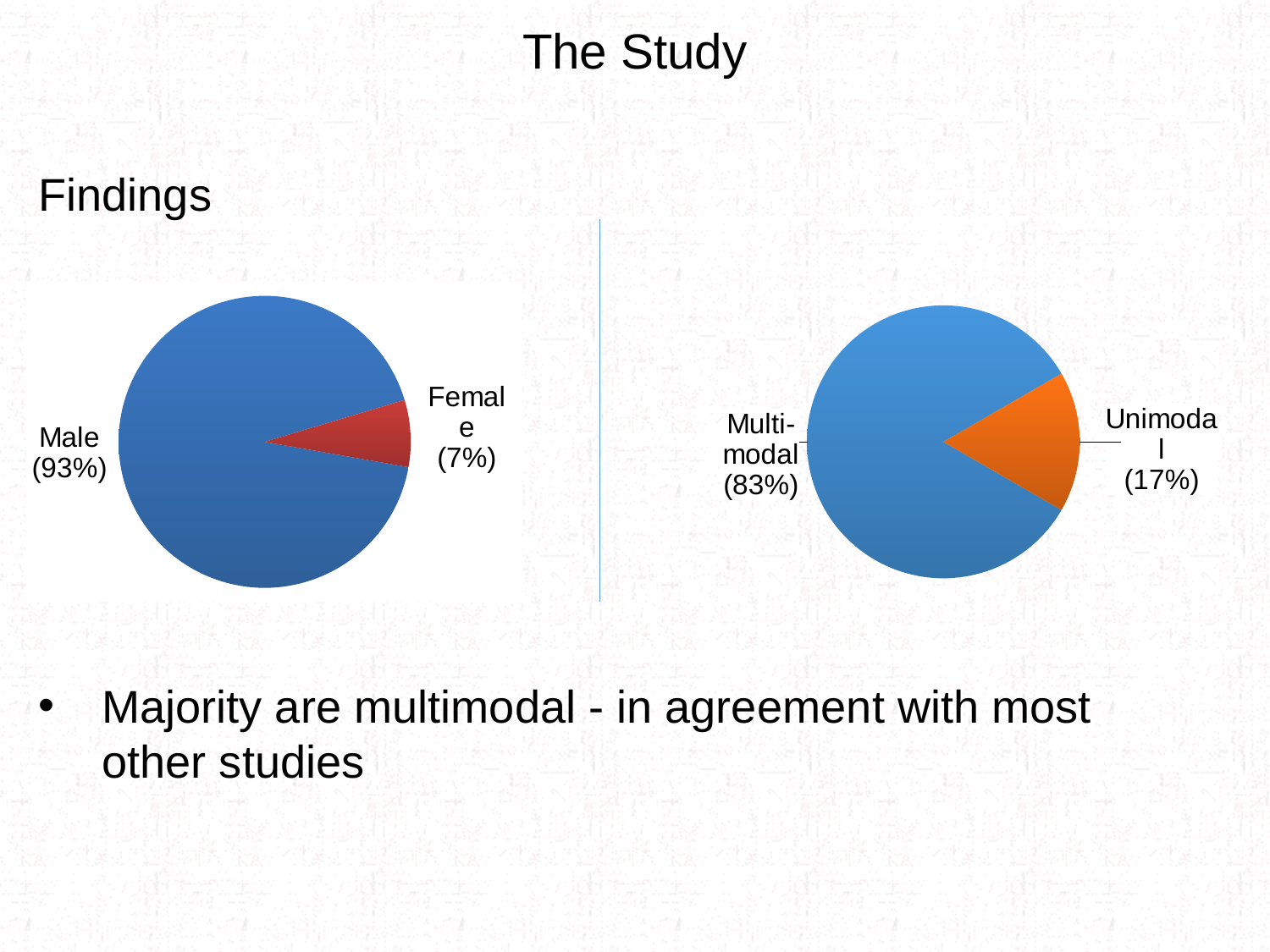
In the right pie chart, which slice is the smallest? Unimodal In the left pie chart, which slice is the largest? Male What kind of chart is the right chart on the slide? Pie chart In the right pie chart, what share is labelled for Multi-modal? 83% How many slices does the left pie chart have? 2 In the right pie chart, which is larger, Multi-modal or Unimodal? Multi-modal In the right pie chart, what colour is the Unimodal slice? Orange In the right pie chart, what is the difference in percentage points between the Multi-modal and Unimodal shares? 66 In the left pie chart, what share is labelled for Female? 7% In the right pie chart, what share is labelled for Unimodal? 17% In the left pie chart, what is the difference in percentage points between the Male and Female shares? 86